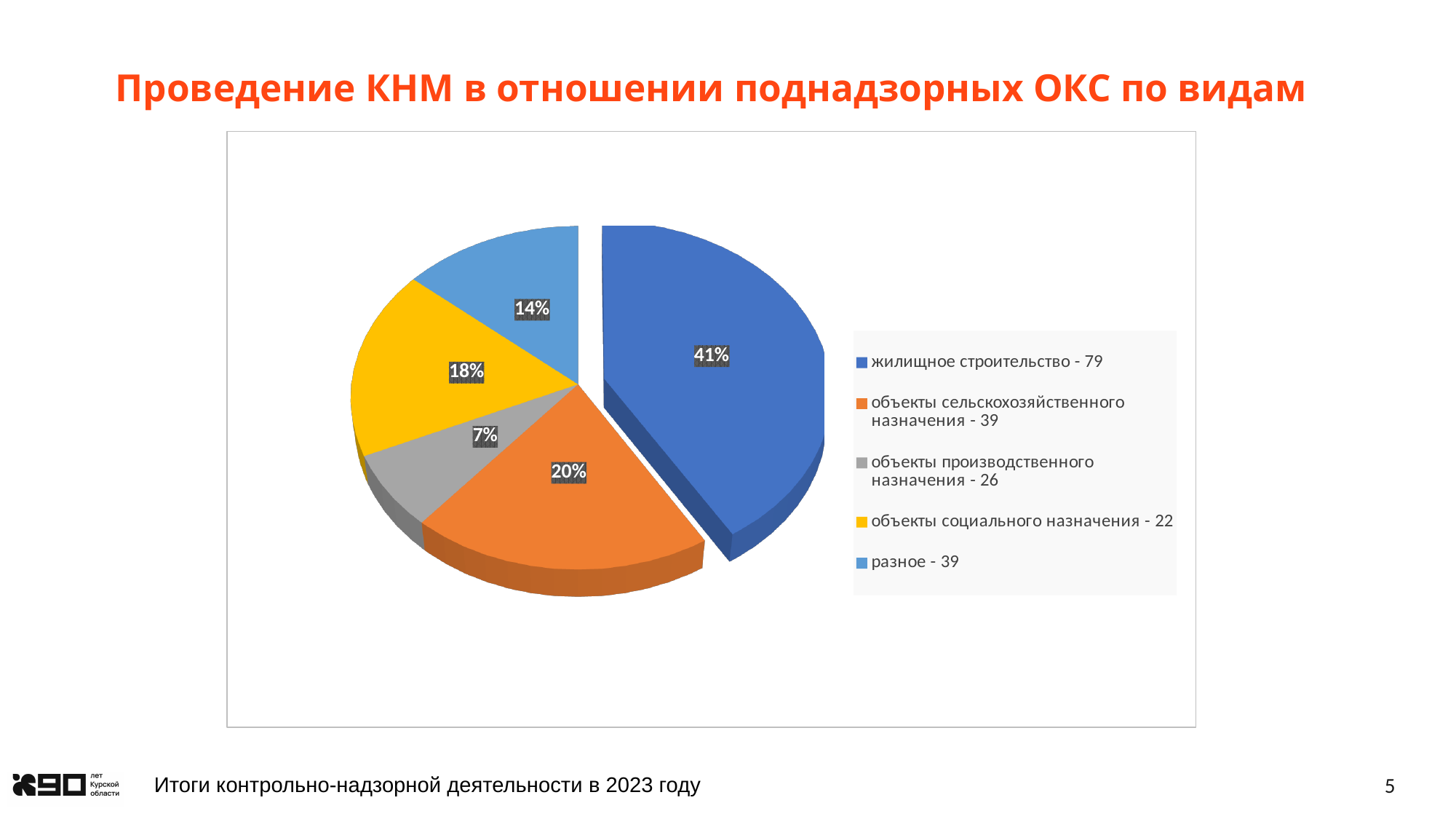
Which category has the smallest slice of the pie? объекты производственного назначения What percentage share is shown for объекты социального назначения? 18% What percentage share is shown for разное? 14% Which category has the largest slice of the pie? жилищное строительство How many slices does the pie chart have? 5 Which slice is larger: объекты социального назначения or разное? объекты социального назначения What percentage share is shown for объекты производственного назначения? 7% What kind of chart is shown on the slide? pie chart What number is shown next to жилищное строительство in the legend? 79 By how many percentage points does the share of жилищное строительство exceed the share of объекты сельскохозяйственного назначения? 21